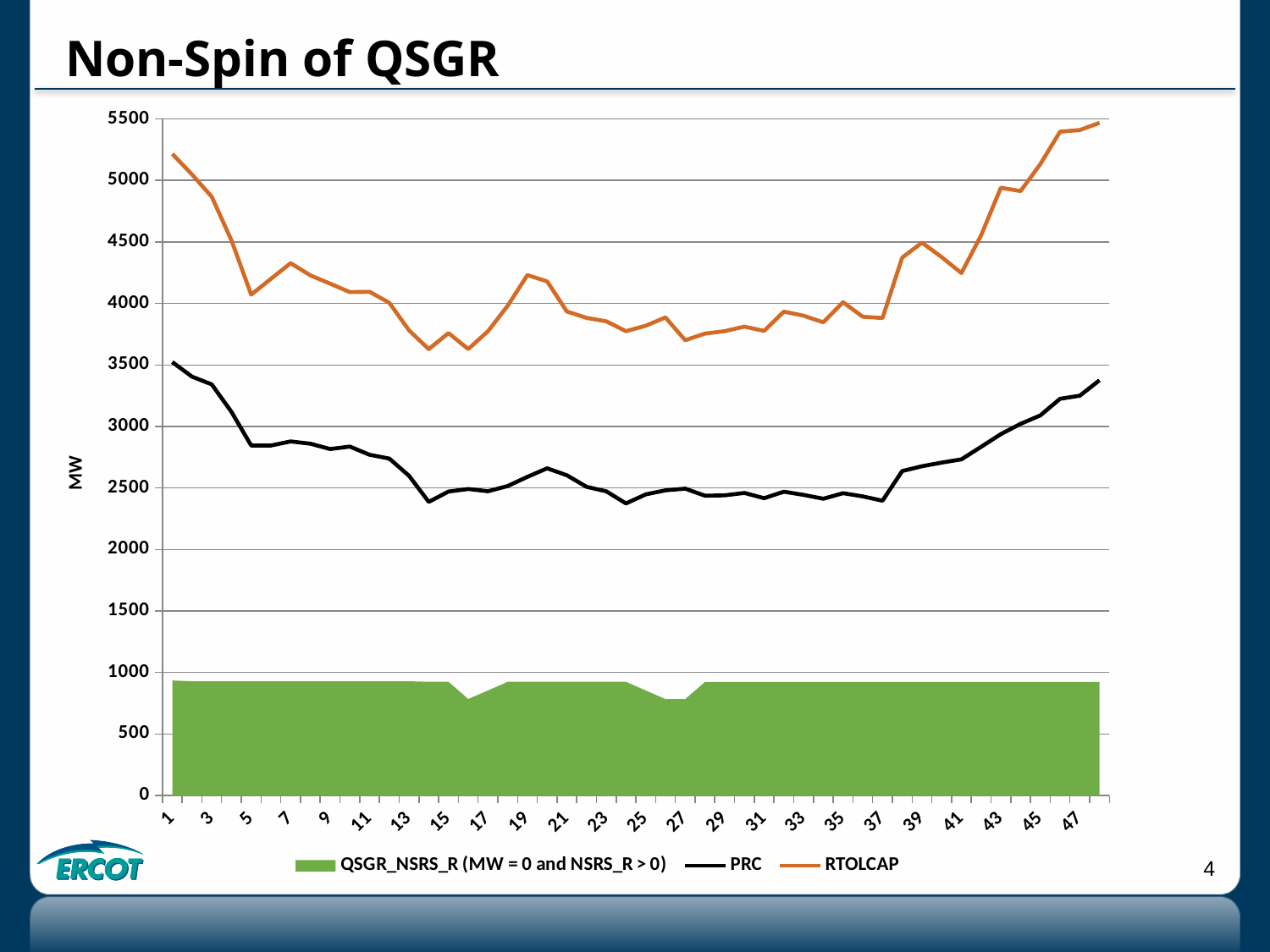
Is the value of RTOLCAP at x = 47 greater or less than 5000? greater Is the value of PRC at x = 5 greater or less than 3000? less Does the RTOLCAP series rise or fall from x = 1 to x = 5? fall What is the label on the y axis? MW Is the value of RTOLCAP at x = 1 greater or less than 5000? greater Does the PRC series rise or fall from x = 37 to x = 47? rise How many series does the legend list? 3 Which series is larger at x = 21, PRC or RTOLCAP? RTOLCAP What is the title of the chart? Non-Spin of QSGR What kind of chart is used to plot the PRC and RTOLCAP series? line chart